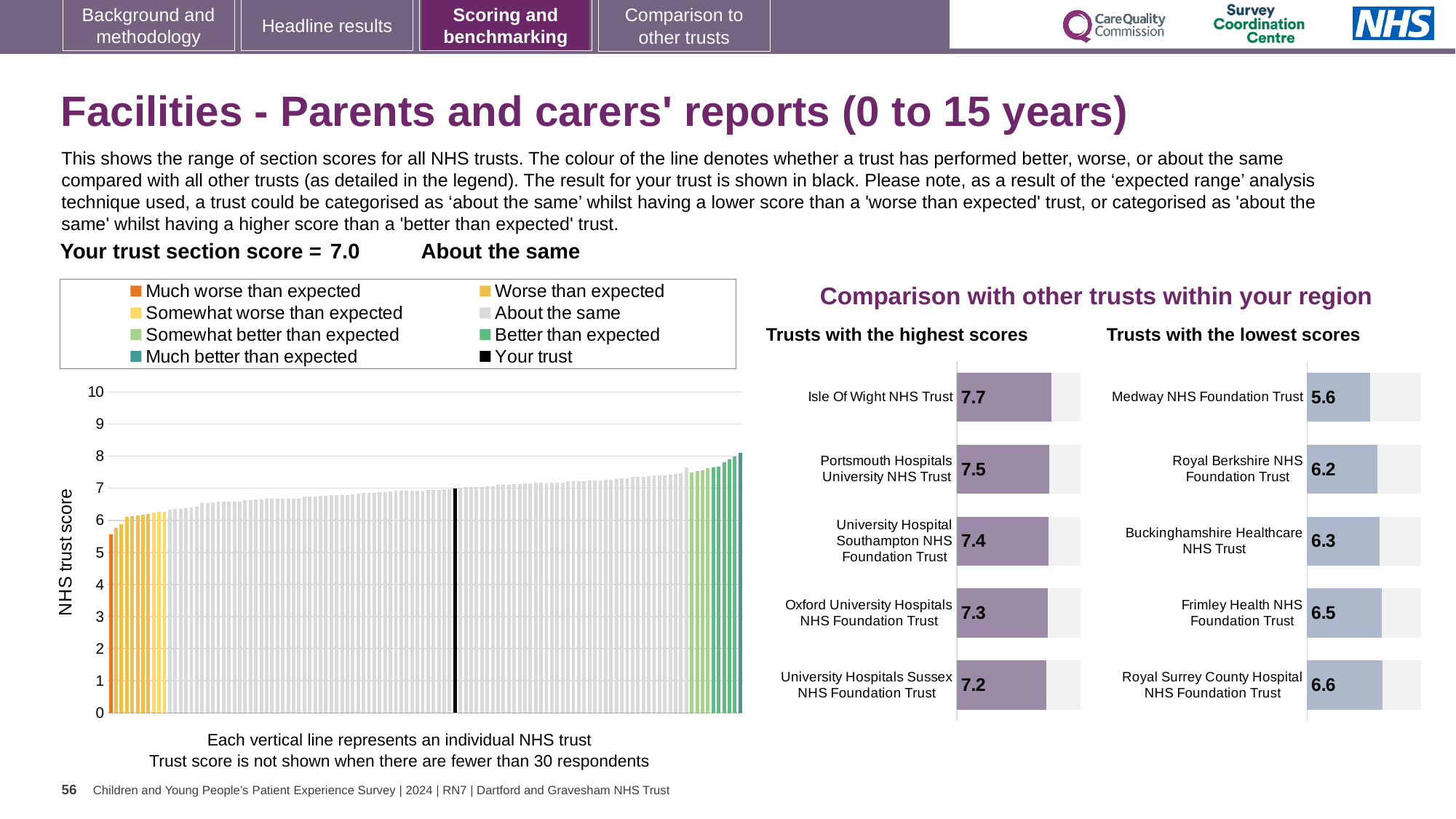
In the 'Trusts with the highest scores' chart, what is the difference between the scores of Isle Of Wight NHS Trust and University Hospitals Sussex NHS Foundation Trust? 0.5 In the 'Trusts with the highest scores' chart, what is the score for Oxford University Hospitals NHS Foundation Trust? 7.3 What kind of chart is the main chart on the left showing the range of section scores? Bar chart In the 'Trusts with the lowest scores' chart, what is the score for Frimley Health NHS Foundation Trust? 6.5 In the 'Trusts with the highest scores' chart, what is the score for Isle Of Wight NHS Trust? 7.7 In the 'Trusts with the lowest scores' chart, what is the difference between the scores of Royal Surrey County Hospital NHS Foundation Trust and Medway NHS Foundation Trust? 1.0 How many trusts are shown in the 'Trusts with the highest scores' chart? 5 In the 'Trusts with the lowest scores' chart, what is the score for Medway NHS Foundation Trust? 5.6 In the main chart on the left, is the value for the lowest-scoring trust (the leftmost bar) greater or less than 6? less In the 'Trusts with the highest scores' chart, which trust has the highest score? Isle Of Wight NHS Trust In the 'Trusts with the lowest scores' chart, which trust has the lowest score? Medway NHS Foundation Trust In the 'Trusts with the lowest scores' chart, which has the higher score: Royal Berkshire NHS Foundation Trust or Buckinghamshire Healthcare NHS Trust? Buckinghamshire Healthcare NHS Trust